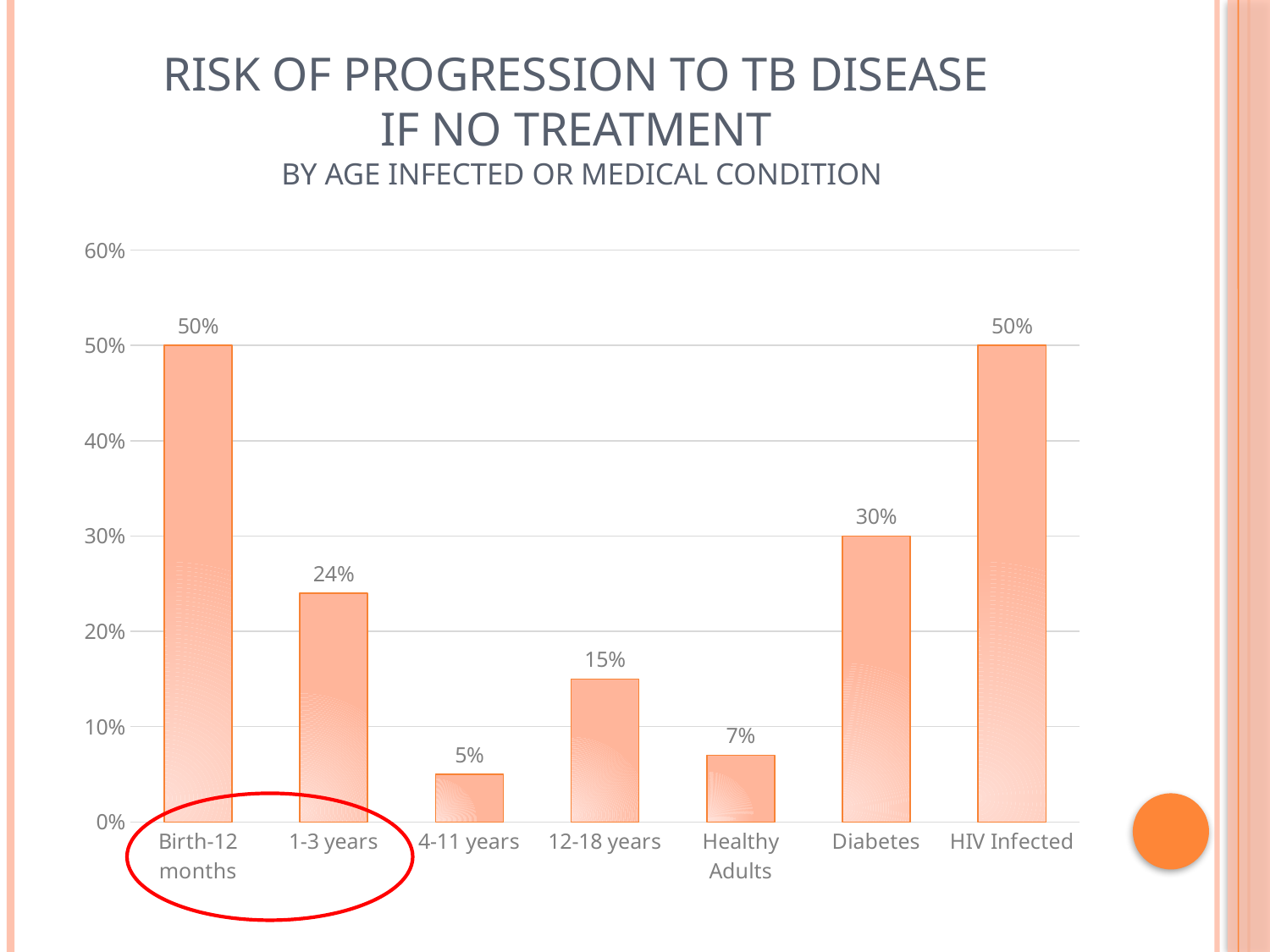
How many categories are shown on the x axis? 7 Is the value for Diabetes greater or less than 20%? greater What kind of chart is shown on the slide? Bar chart What is the value shown for Diabetes? 30% What is the difference between the values for Birth-12 months and 1-3 years? 26% What is the value shown for Healthy Adults? 7% Which categories are circled in red on the chart? Birth-12 months and 1-3 years What is the difference between the values for Diabetes and Healthy Adults? 23% Which two categories share the highest value of 50%? Birth-12 months and HIV Infected What is the risk of progression to TB disease for the 1-3 years category? 24% Which is larger, the value for 12-18 years or the value for Healthy Adults? 12-18 years Which category has the lowest risk of progression to TB disease? 4-11 years